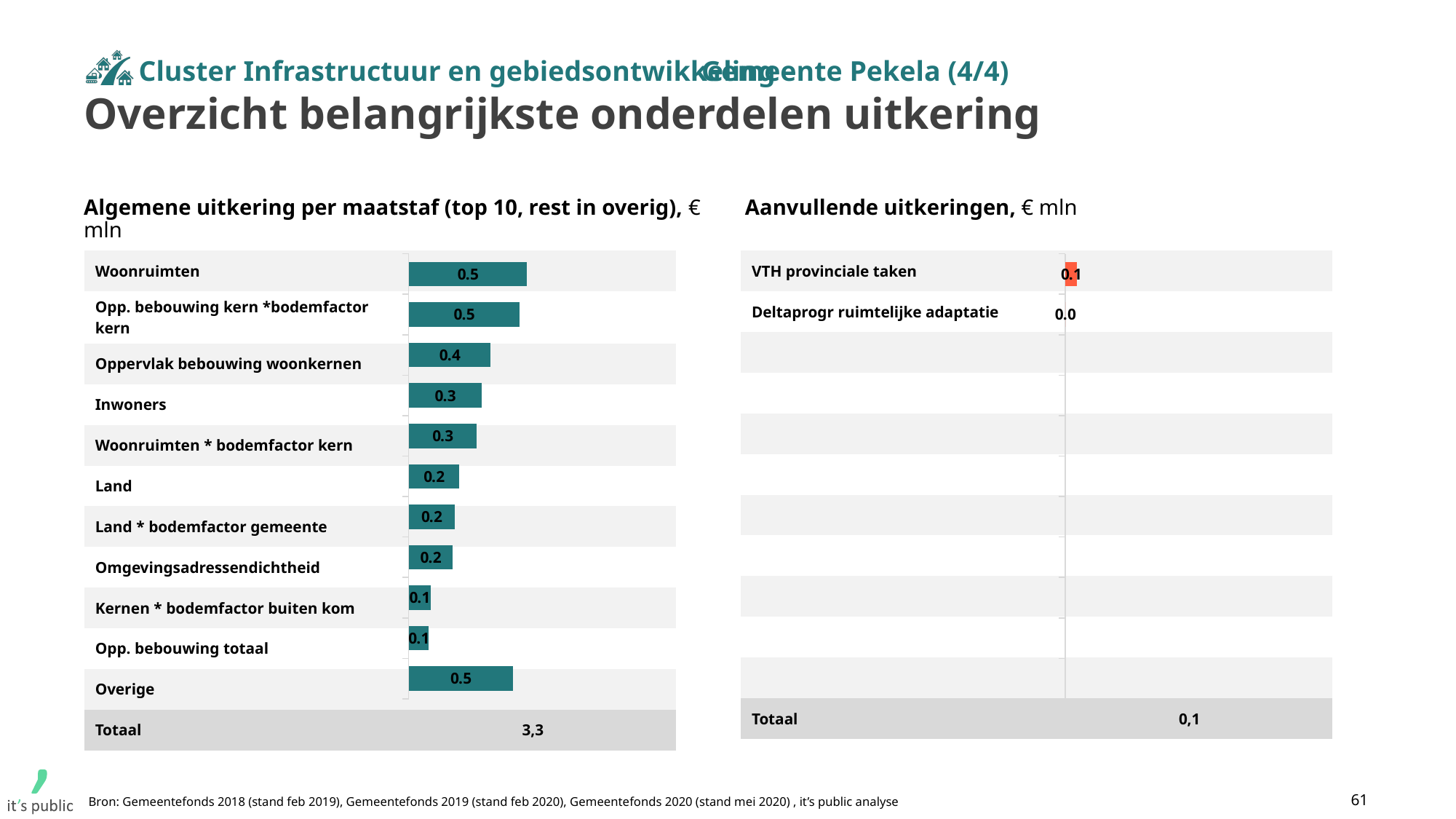
In the chart 'Algemene uitkering per maatstaf', what is the value for Inwoners? 0.3 In the chart 'Algemene uitkering per maatstaf', what is the value for Overige? 0.5 How many categories (including Overige) are plotted in the chart 'Algemene uitkering per maatstaf'? 11 In the chart 'Algemene uitkering per maatstaf', what is the value for Oppervlak bebouwing woonkernen? 0.4 What kind of chart is 'Aanvullende uitkeringen'? Bar chart In the chart 'Aanvullende uitkeringen', what is the value for Deltaprogr ruimtelijke adaptatie? 0.0 In the chart 'Algemene uitkering per maatstaf', what is the difference between Woonruimten and Land? 0.3 In the chart 'Aanvullende uitkeringen', what is the value for VTH provinciale taken? 0.1 In the chart 'Algemene uitkering per maatstaf', what is the value for Omgevingsadressendichtheid? 0.2 In the chart 'Algemene uitkering per maatstaf', what is the value for Woonruimten? 0.5 In the chart 'Algemene uitkering per maatstaf', what is the Totaal shown at the bottom? 3,3 In the chart 'Algemene uitkering per maatstaf', which is larger: Woonruimten or Inwoners? Woonruimten